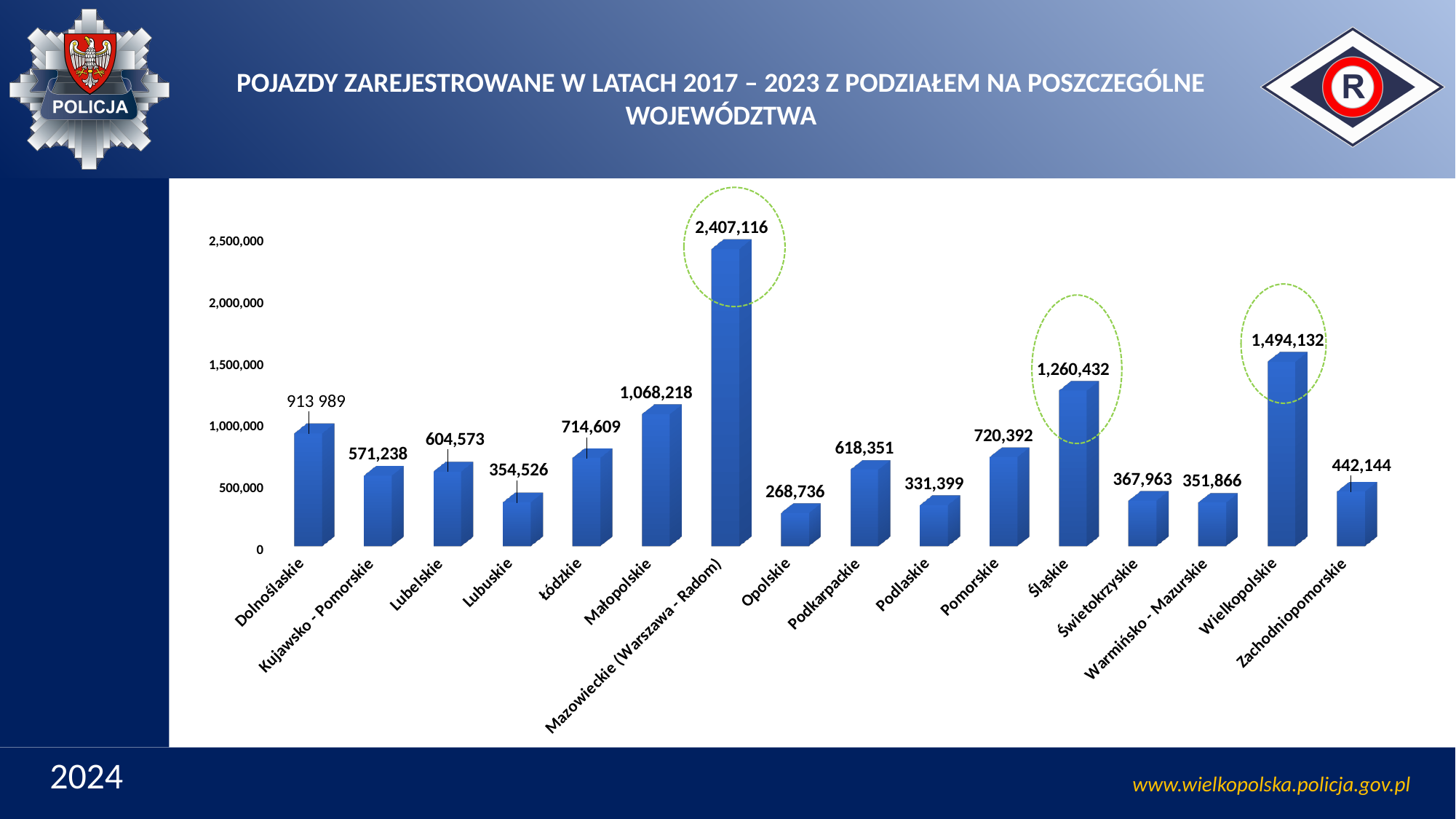
What is the difference between the values for Mazowieckie (Warszawa - Radom) and Wielkopolskie? 912,984 What kind of chart is shown on the slide? bar chart What is the value for Wielkopolskie? 1,494,132 What is the value for Śląskie? 1,260,432 Which is larger, the value for Pomorskie or the value for Podkarpackie? Pomorskie What is the value for Mazowieckie (Warszawa - Radom)? 2,407,116 Which voivodeship has the highest value? Mazowieckie (Warszawa - Radom) How many voivodeships are shown on the x axis? 16 What is the difference between the values for Śląskie and Małopolskie? 192,214 What is the value for Opolskie? 268,736 Which voivodeship has the lowest value? Opolskie Is the value for Lubuskie greater or less than 500,000? less